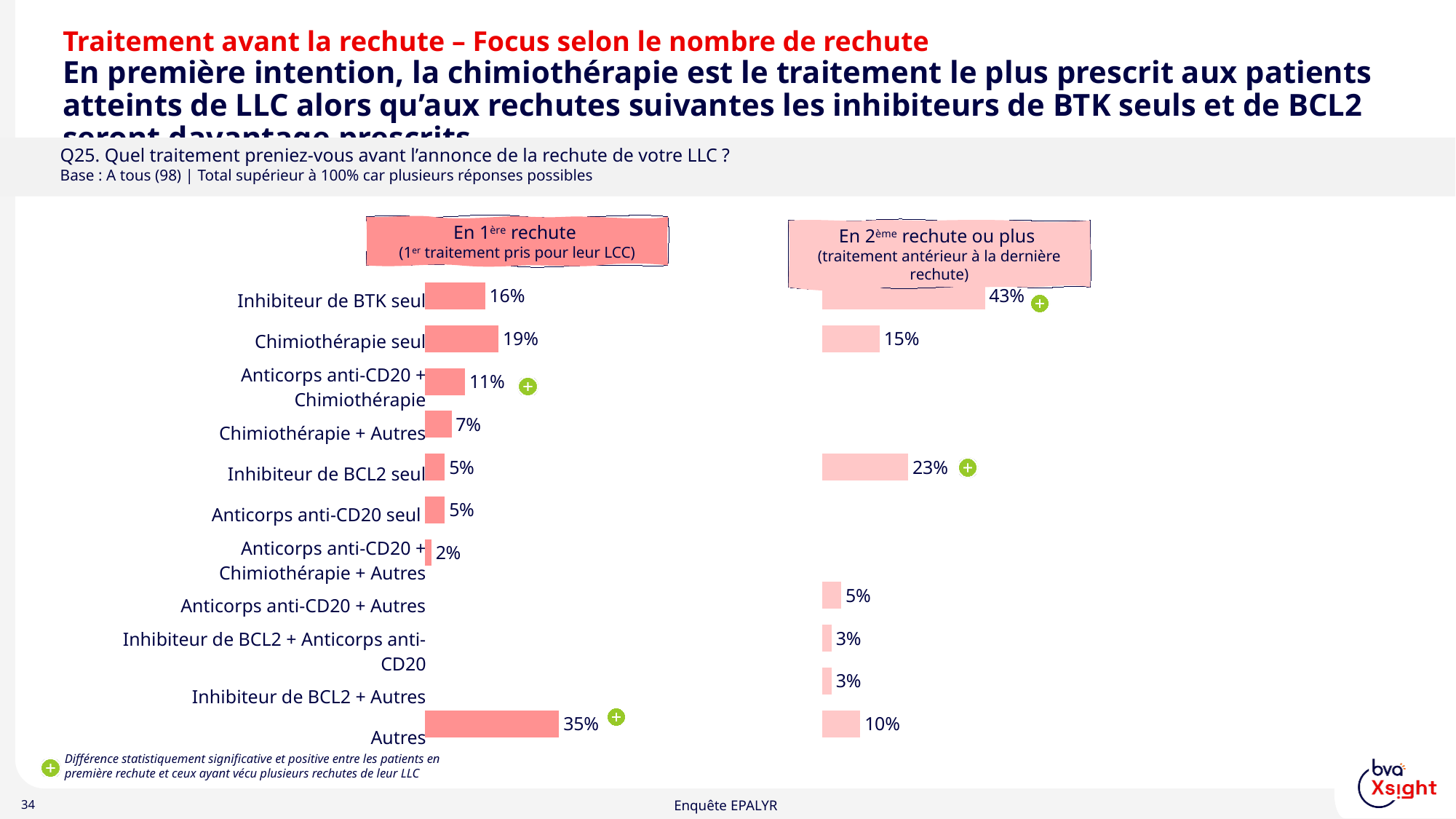
In the 'En 1ère rechute' chart, which category has the highest value? Autres In the 'En 2ème rechute ou plus' chart, what is the value for Inhibiteur de BCL2 seul? 23% Which is larger: Chimiothérapie seul in the 'En 1ère rechute' chart or Chimiothérapie seul in the 'En 2ème rechute ou plus' chart? En 1ère rechute In the 'En 2ème rechute ou plus' chart, what is the value for Autres? 10% In the 'En 2ème rechute ou plus' chart, which category has the highest value? Inhibiteur de BTK seul In the 'En 1ère rechute' chart, what is the value for Inhibiteur de BTK seul? 16% In the 'En 1ère rechute' chart, what is the difference between Chimiothérapie seul and Chimiothérapie + Autres? 12 percentage points In the 'En 1ère rechute' chart, which category has the lowest value? Anticorps anti-CD20 + Chimiothérapie + Autres In the 'En 1ère rechute' chart, what is the value for Chimiothérapie seul? 19% In the 'En 2ème rechute ou plus' chart, what is the value for Inhibiteur de BTK seul? 43% What is the difference between the Inhibiteur de BTK seul values in the 'En 2ème rechute ou plus' chart and the 'En 1ère rechute' chart? 27 percentage points What type of chart is used on this slide? Bar chart